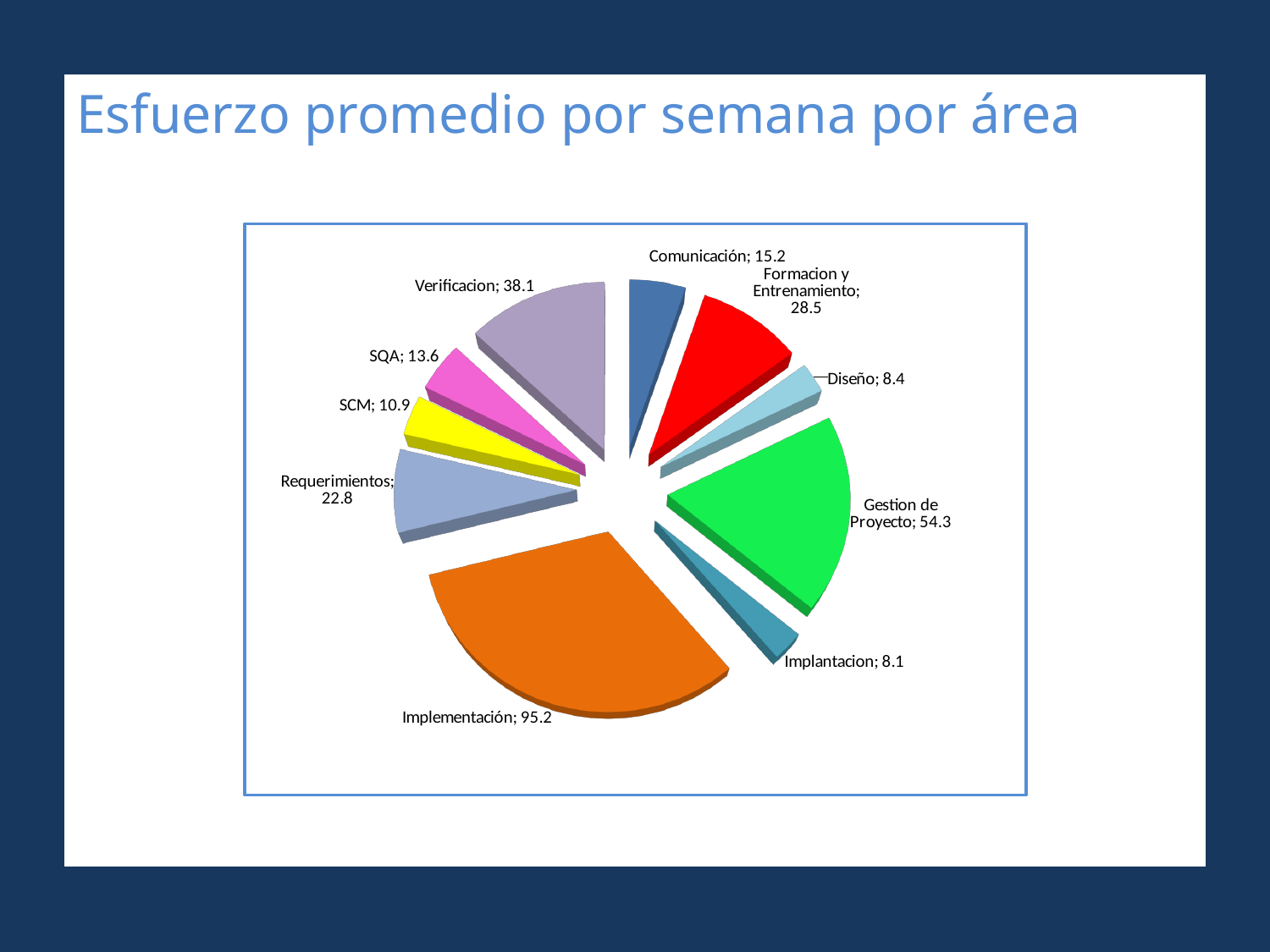
What type of chart is shown on the slide? pie chart What is the value for Formacion y Entrenamiento? 28.5 What is the value for SCM? 10.9 Which area has the lowest value? Implantacion What is the value for Implementación? 95.2 Which is larger, the value for Requerimientos or the value for SQA? Requerimientos What is the difference between the values for Verificacion and Formacion y Entrenamiento? 9.6 What is the difference between the values for Implementación and Gestion de Proyecto? 40.9 Which area has the highest value? Implementación What is the value for Gestion de Proyecto? 54.3 How many areas (slices) are shown in the pie chart? 10 What is the title of the slide? Esfuerzo promedio por semana por área